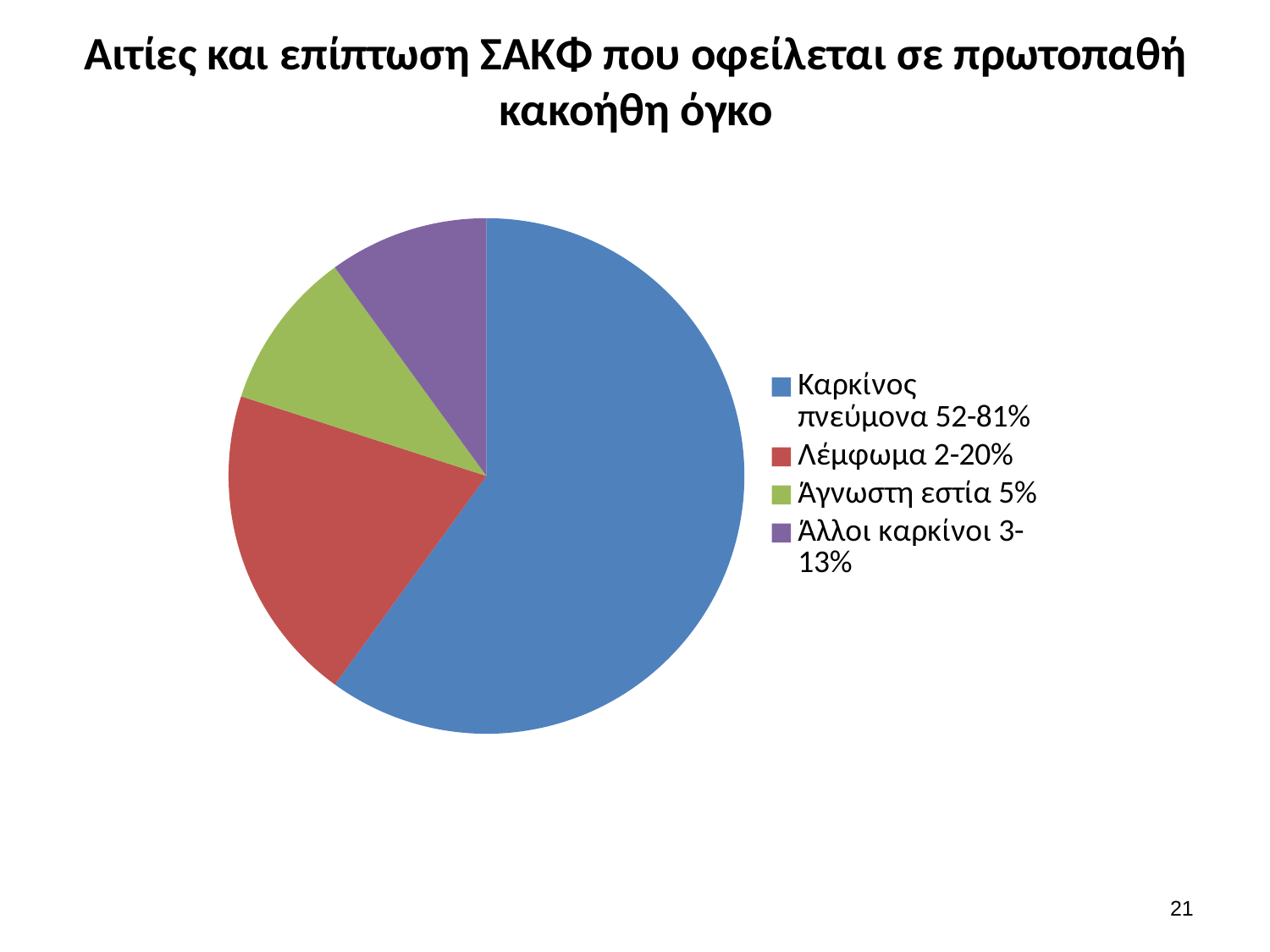
Which slice is larger, Λέμφωμα or Άγνωστη εστία? Λέμφωμα How many slices does the pie chart have? 4 What colour is the slice for Άγνωστη εστία? green What percentage range is printed in the legend for Λέμφωμα? 2-20% What percentage range is printed in the legend for Άλλοι καρκίνοι? 3-13% Which slice is larger, Καρκίνος πνεύμονα or Λέμφωμα? Καρκίνος πνεύμονα What percentage range is printed in the legend for Καρκίνος πνεύμονα? 52-81% What percentage is printed in the legend for Άγνωστη εστία? 5% What is the title of the slide? Αιτίες και επίπτωση ΣΑΚΦ που οφείλεται σε πρωτοπαθή κακοήθη όγκο What kind of chart is shown on the slide? pie chart Which category has the largest slice of the pie? Καρκίνος πνεύμονα 52-81% How many entries does the legend list? 4